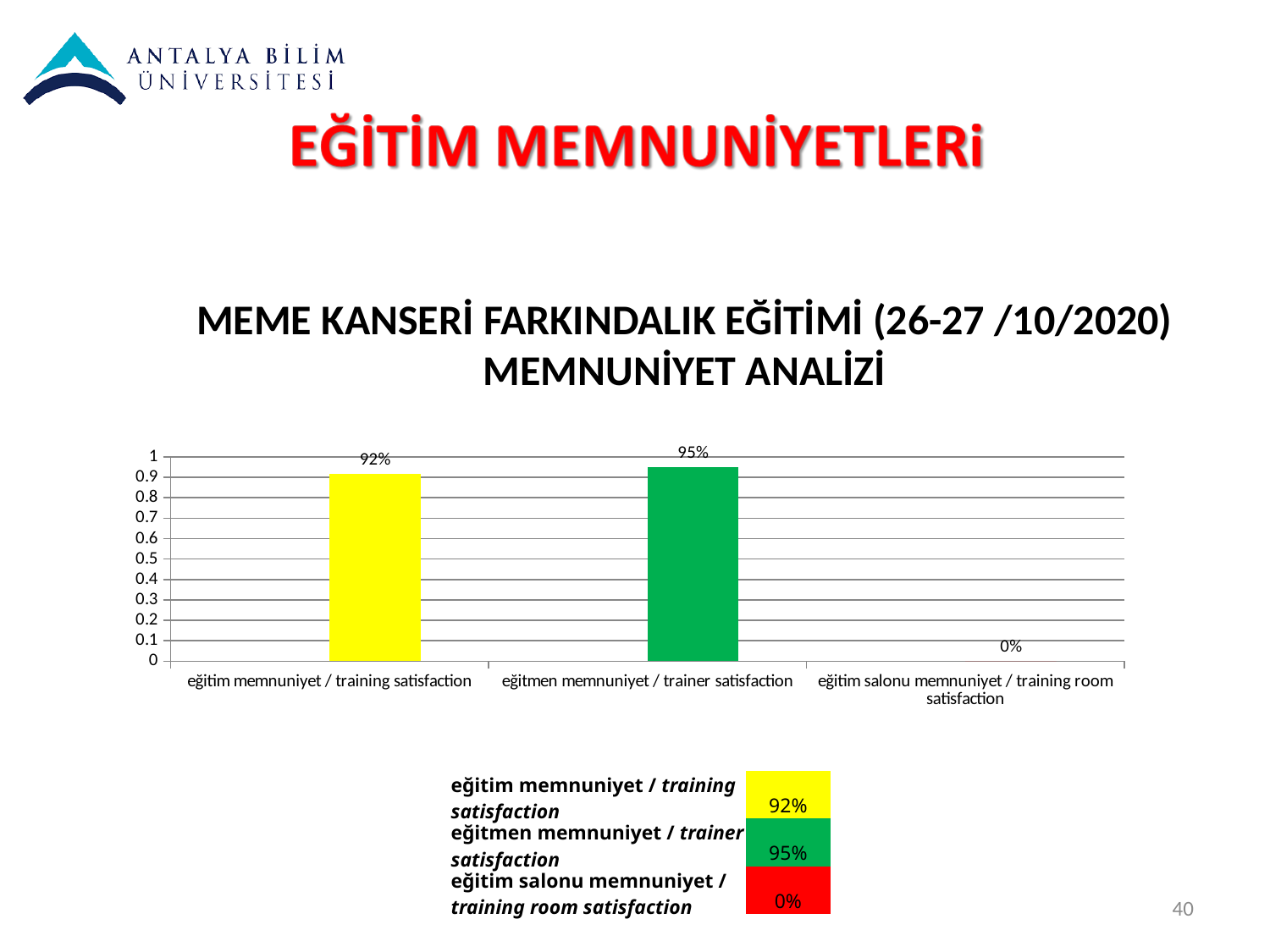
What is the value for eğitim salonu memnuniyet / training room satisfaction? 0% What is the title of the chart? MEME KANSERİ FARKINDALIK EĞİTİMİ (26-27 /10/2020) MEMNUNİYET ANALİZİ Is the value for eğitim memnuniyet / training satisfaction greater or less than 0.5 on the axis? greater What colour is the bar for eğitmen memnuniyet / trainer satisfaction? green Which category has the highest value? eğitmen memnuniyet / trainer satisfaction Which is larger, the value for eğitim memnuniyet / training satisfaction or the value for eğitmen memnuniyet / trainer satisfaction? eğitmen memnuniyet / trainer satisfaction What is the value for eğitim memnuniyet / training satisfaction? 92% What kind of chart is shown on the slide? bar chart Which category has the lowest value? eğitim salonu memnuniyet / training room satisfaction What is the difference between the values for eğitmen memnuniyet / trainer satisfaction and eğitim memnuniyet / training satisfaction? 3% How many categories are shown on the x axis of the chart? 3 What is the value for eğitmen memnuniyet / trainer satisfaction? 95%